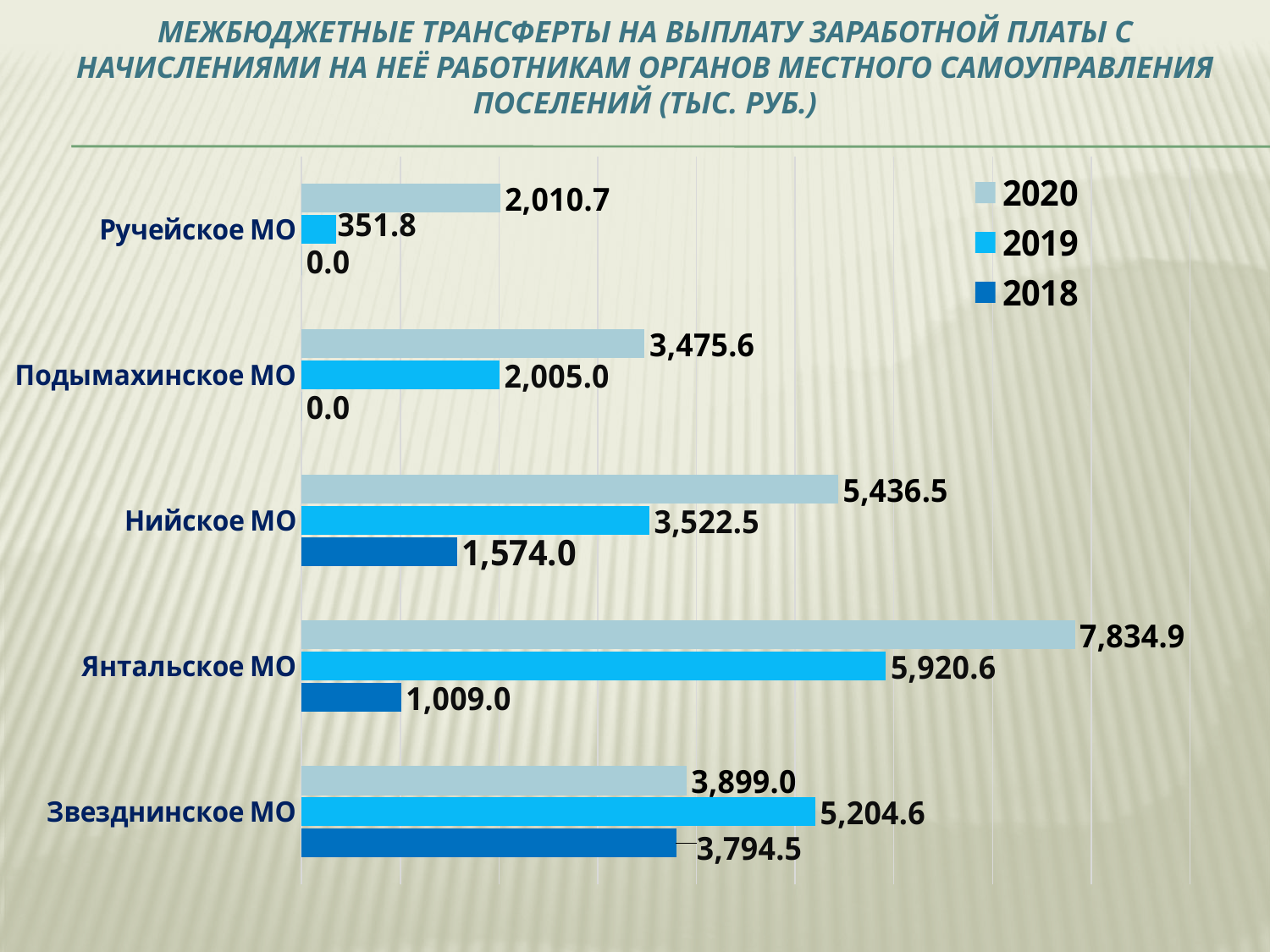
For Звезднинское МО, which is larger: the 2020 value or the 2019 value? 2019 How many series does the legend list? 3 What is the difference between the 2019 and 2018 values for Звезднинское МО? 1,410.1 What is the 2020 value for Янтальское МО? 7,834.9 What is the 2018 value for Звезднинское МО? 3,794.5 Which category has the highest 2020 value? Янтальское МО What kind of chart is shown on the slide? Bar chart What is the difference between the 2020 and 2019 values for Янтальское МО? 1,914.3 Which year does the legend associate with the dark blue colour? 2018 What is the 2019 value for Ручейское МО? 351.8 Which category has the lowest 2019 value? Ручейское МО How many municipalities (categories) are shown in the chart? 5